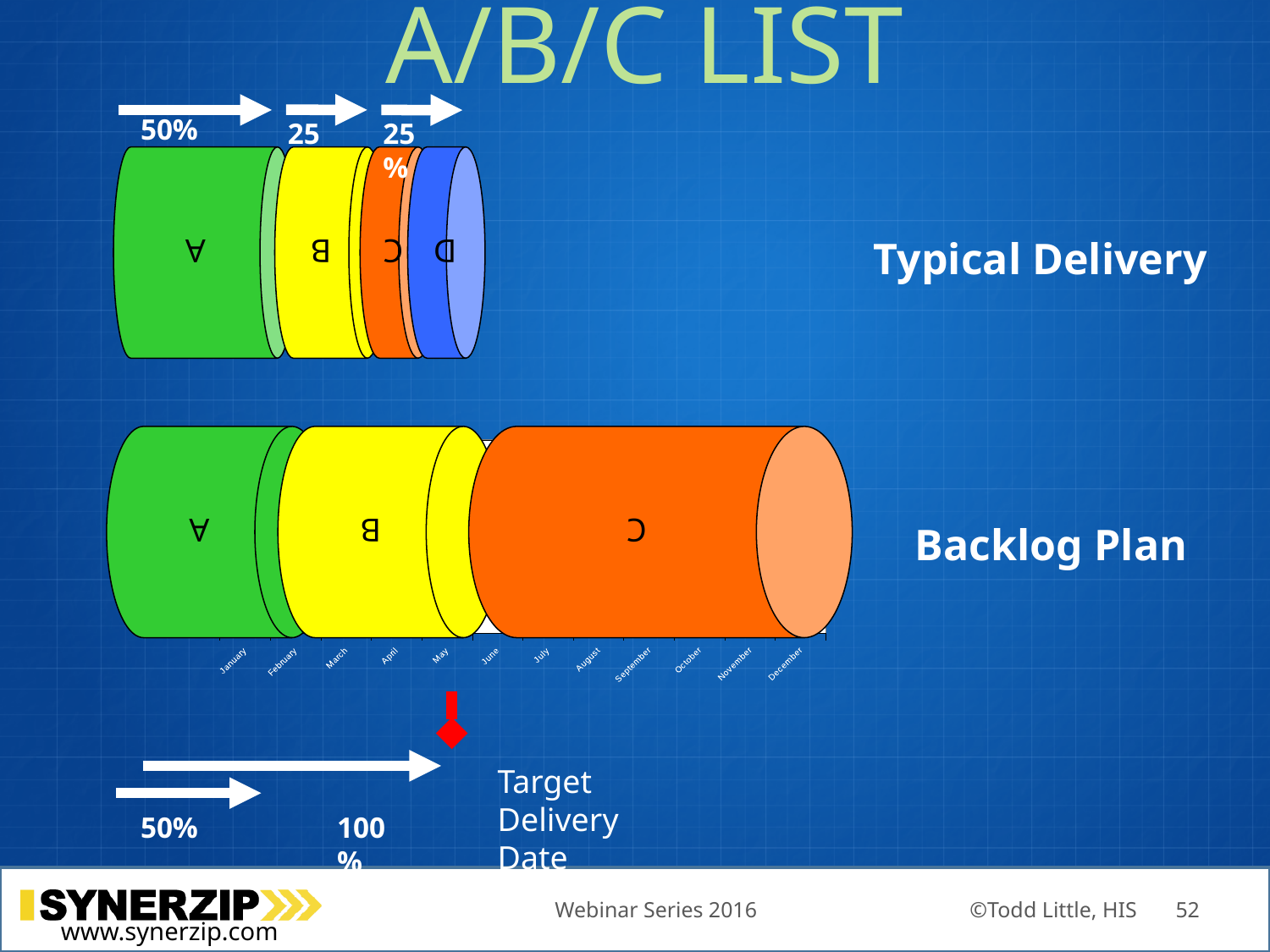
In the Backlog Plan chart, which segment is the shortest? A In the Typical Delivery chart, how many segments are shown? 4 In the Backlog Plan chart, how many segments are shown? 3 In the Typical Delivery chart, which segment is the longest? A How many month labels appear on the axis below the Backlog Plan chart? 12 In the Typical Delivery chart, is segment A longer or shorter than segment B? longer What are the segment labels in the Typical Delivery chart, in order from left to right? A, B, C, D In the Backlog Plan chart, which segment is the longest? C What colour is segment C in the Backlog Plan chart? Orange In the Backlog Plan chart, is segment C longer or shorter than segment B? longer